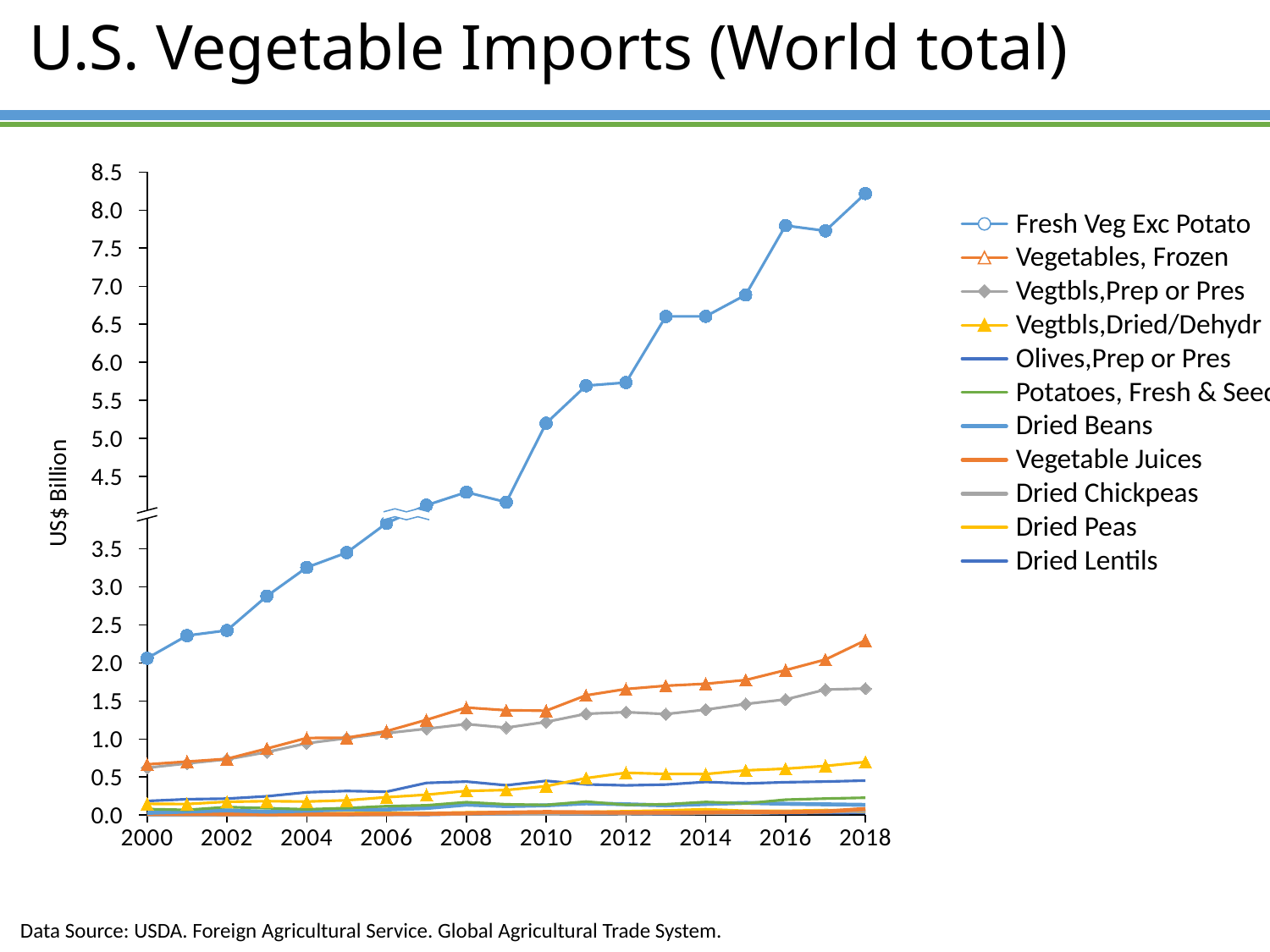
How many series does the legend list? 11 In 2018, which is larger: Vegetables, Frozen or Vegtbls,Prep or Pres? Vegetables, Frozen What is the label on the y axis? US$ Billion Is the value for Fresh Veg Exc Potato in 2010 greater or less than 5.0? greater Is the value for Fresh Veg Exc Potato in 2018 greater or less than 8.0? greater Which series has the highest value in 2018? Fresh Veg Exc Potato What is the title of the chart? U.S. Vegetable Imports (World total) Does the Fresh Veg Exc Potato series generally rise or fall from 2000 to 2018? rise What kind of chart is shown on the slide? line chart In which year does Fresh Veg Exc Potato reach its highest value? 2018 How many years are plotted along the x axis? 19 Is the value for Vegetables, Frozen in 2018 greater or less than 2.0? greater